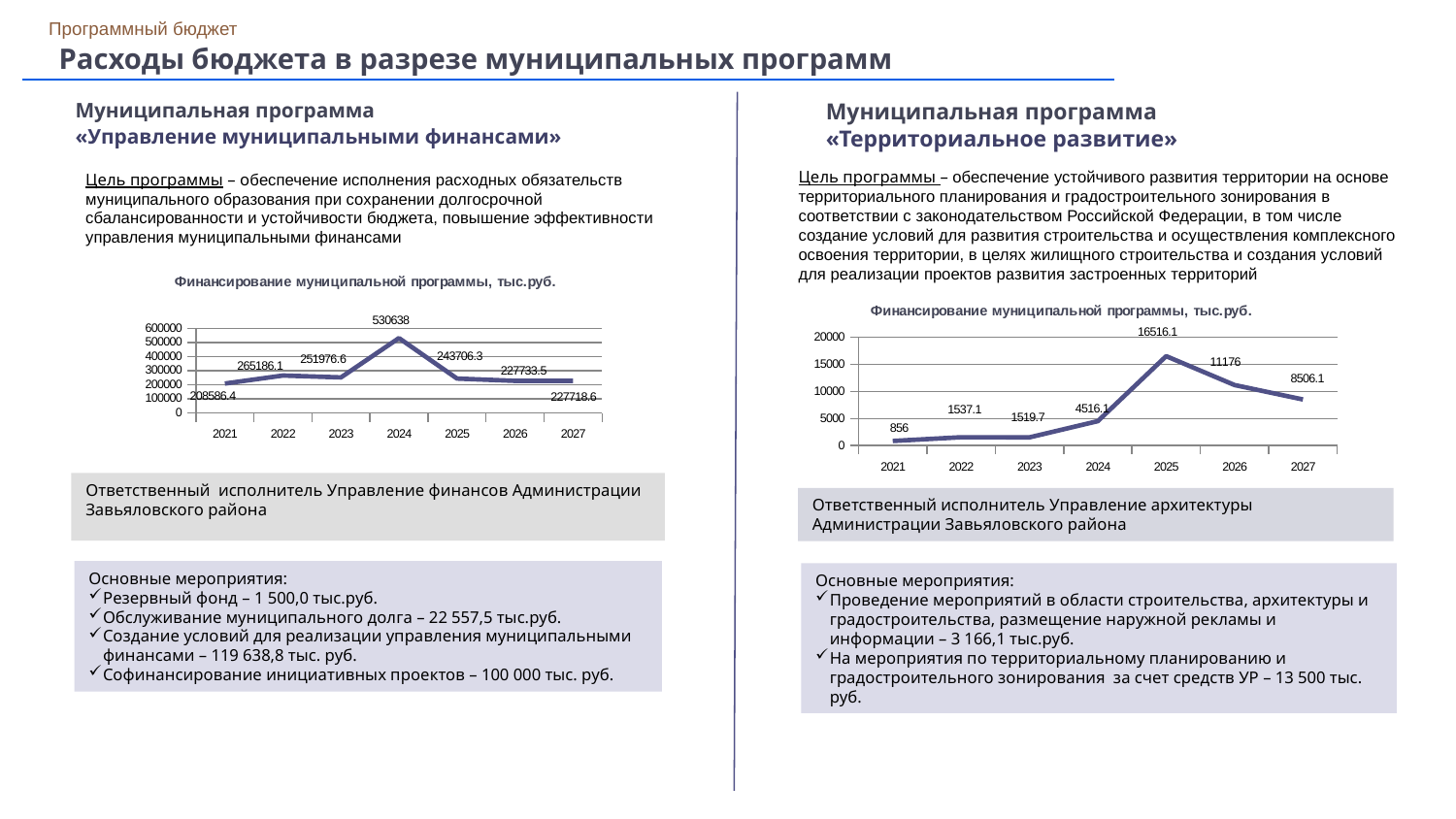
What type of chart is used on the left for the program «Управление муниципальными финансами»? Line chart On the left chart (Управление муниципальными финансами), what is the value for 2024? 530638 On the right chart (Территориальное развитие), which is larger: the value for 2026 or the value for 2027? 2026 On the left chart (Управление муниципальными финансами), which year has the highest value? 2024 On the left chart (Управление муниципальными финансами), which year has the lowest value? 2021 On the right chart (Территориальное развитие), which year has the lowest value? 2021 On the left chart (Управление муниципальными финансами), what is the difference between the values for 2022 and 2023? 13209.5 On the right chart (Территориальное развитие), what is the value for 2027? 8506.1 On the left chart (Управление муниципальными финансами), what is the value for 2021? 208586.4 On the right chart (Территориальное развитие), what is the value for 2025? 16516.1 How many years are plotted on the right chart (Территориальное развитие)? 7 On the right chart (Территориальное развитие), what is the difference between the values for 2025 and 2026? 5340.1